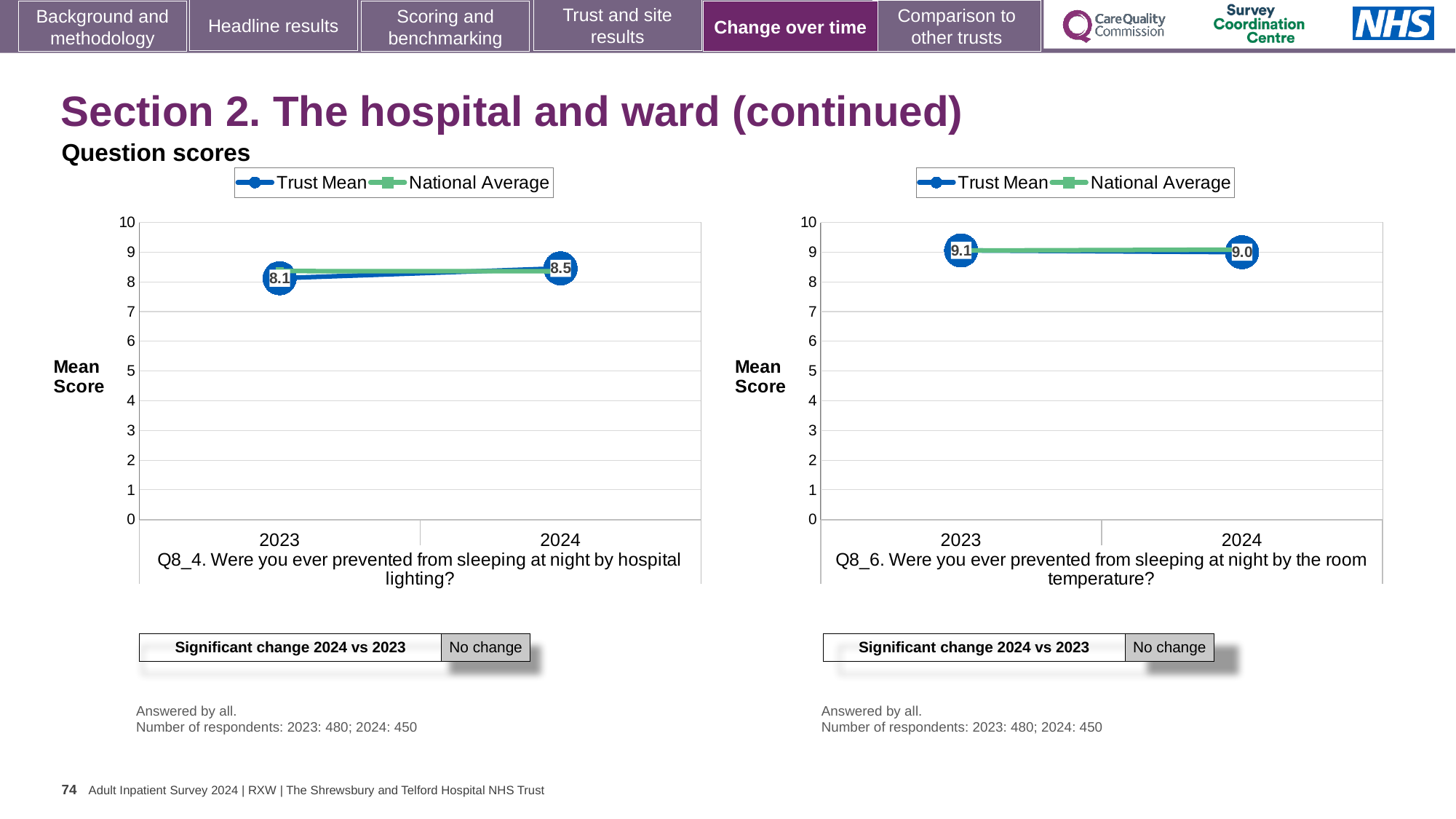
On the Q8_6 chart (right), does the Trust Mean rise or fall from 2023 to 2024? fall On the Q8_6 chart (right), what is the difference between the Trust Mean for 2023 and 2024? 0.1 On the Q8_4 chart (left), what is the Trust Mean score for 2023? 8.1 What kind of chart is the Q8_6 chart (right)? line chart On the Q8_6 chart (right), what is the Trust Mean score for 2024? 9.0 How many years are shown on the x axis of the Q8_6 chart (right)? 2 On the Q8_4 chart (left), what is the Trust Mean score for 2024? 8.5 On the Q8_4 chart (left), by how much did the Trust Mean change from 2023 to 2024? 0.4 On the Q8_6 chart (right), what is the Trust Mean score for 2023? 9.1 On the Q8_4 chart (left), is the National Average for 2023 greater or less than 8? greater How many series does the legend of the Q8_4 chart (left) list? 2 On the Q8_4 chart (left), does the Trust Mean rise or fall from 2023 to 2024? rise